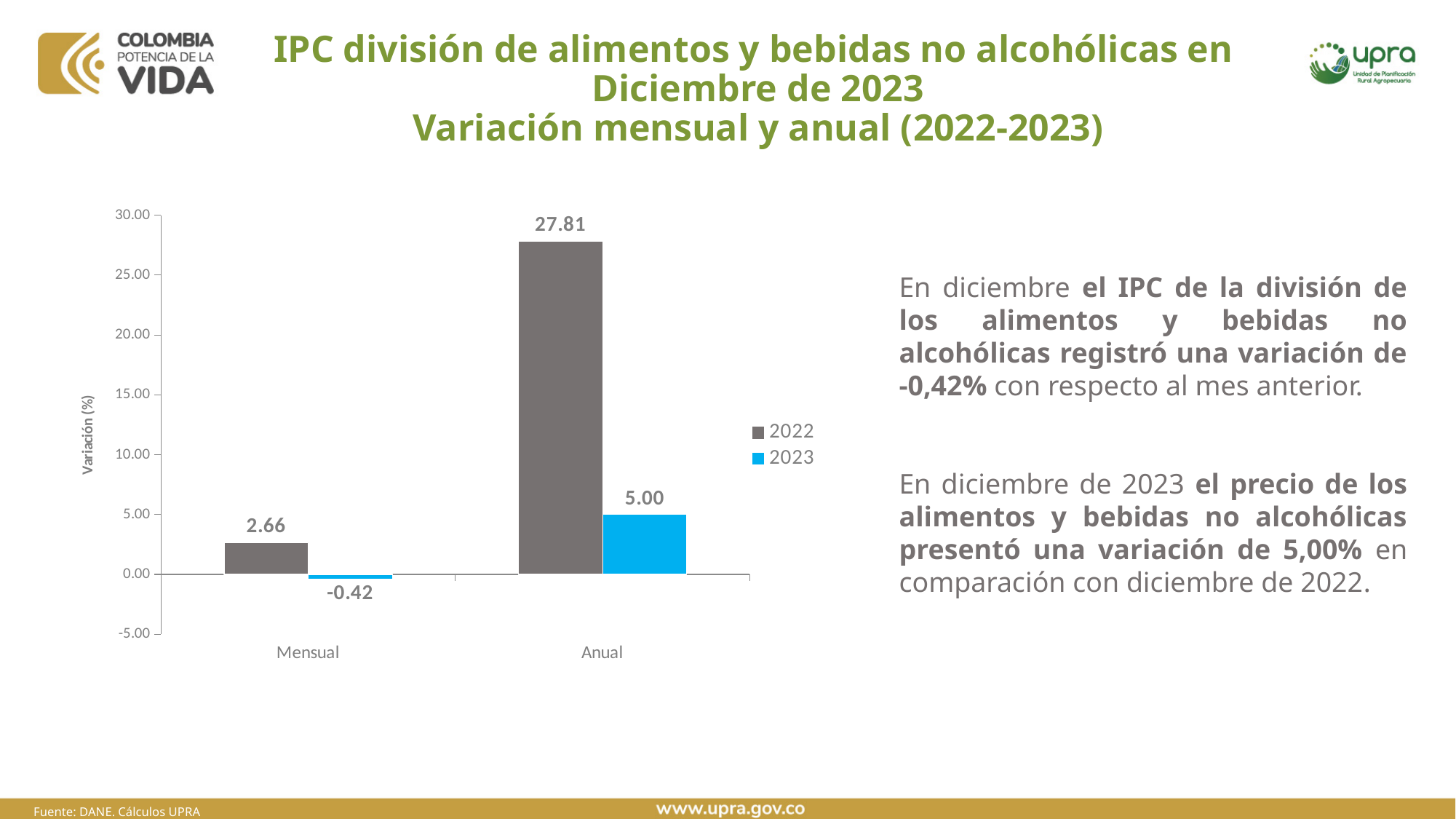
What is the label of the vertical axis? Variación (%) What is the difference between the 2022 and 2023 values in the Anual category? 22.81 What is the value for 2023 in the Mensual category? -0.42 Which bar has the highest value on the chart? 2022 Anual How many series does the legend list? 2 Which is larger, the 2023 value for Mensual or the 2023 value for Anual? Anual What is the value for 2023 in the Anual category? 5.00 What is the difference between the 2022 and 2023 values in the Mensual category? 3.08 What is the value for 2022 in the Mensual category? 2.66 What kind of chart is shown on the slide? Bar chart Which bar has the lowest value on the chart? 2023 Mensual What is the value for 2022 in the Anual category? 27.81